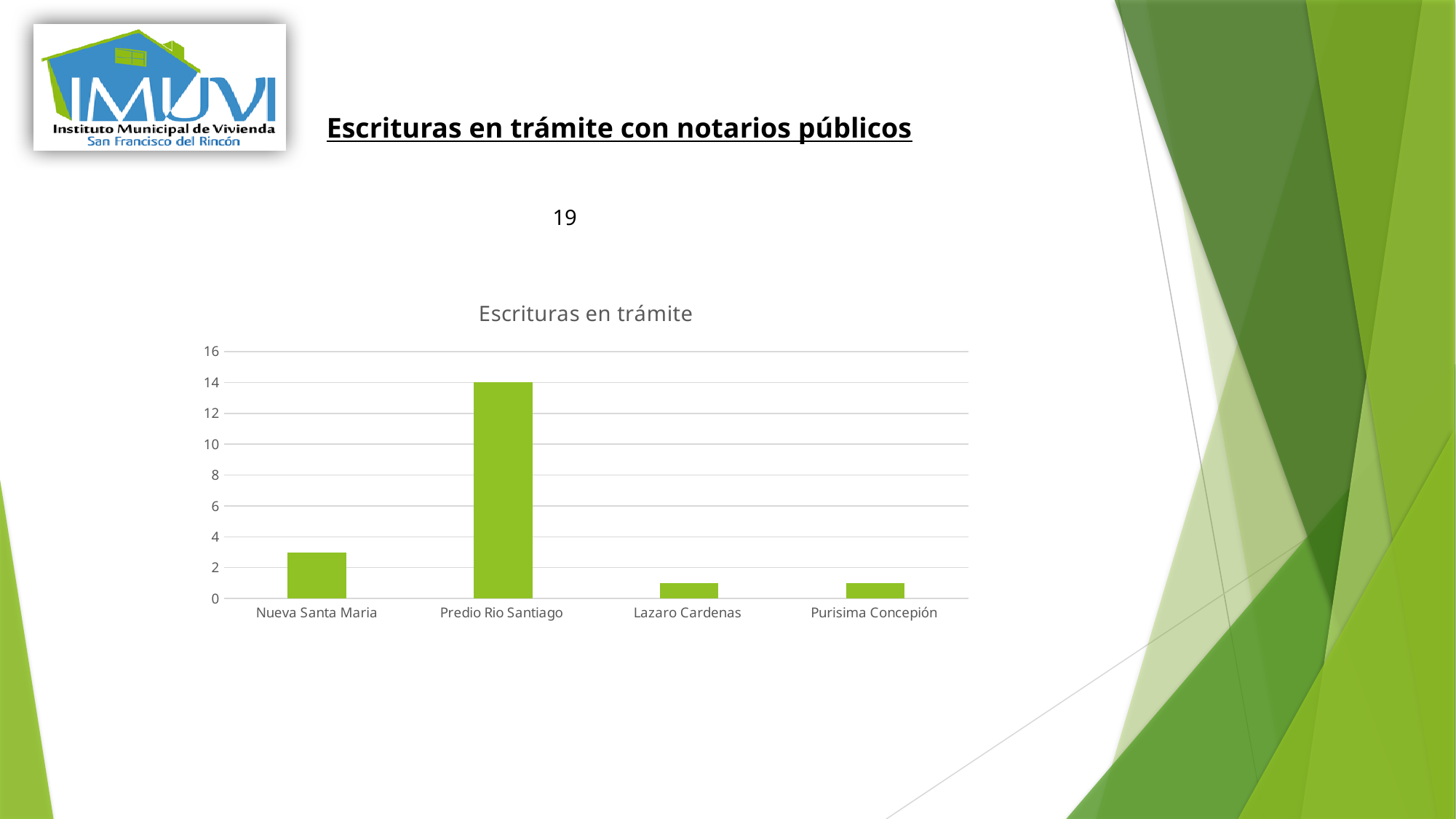
Is the value for Purisima Concepión greater or less than 2? less Is the value for Nueva Santa Maria greater or less than 2? greater Which is larger, the value for Predio Rio Santiago or the value for Purisima Concepión? Predio Rio Santiago Is the value for Nueva Santa Maria greater or less than 4? less Which is larger, the value for Nueva Santa Maria or the value for Lazaro Cardenas? Nueva Santa Maria Which category has the highest value? Predio Rio Santiago How many categories are shown on the x axis of the chart? 4 What is the title of the chart? Escrituras en trámite What is the value for Predio Rio Santiago? 14 What type of chart is shown on the slide? bar chart